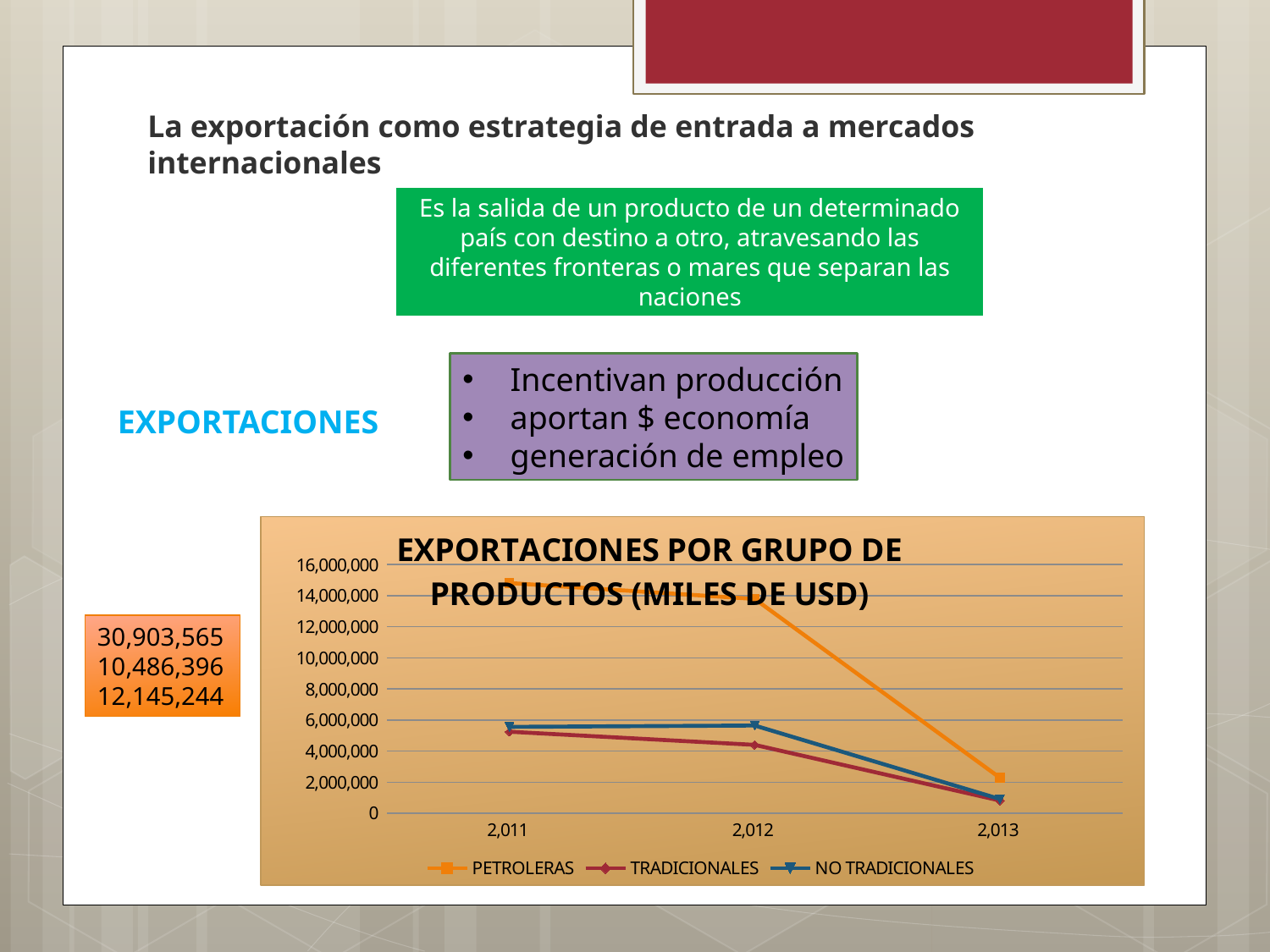
What is the title of the chart? EXPORTACIONES POR GRUPO DE PRODUCTOS (MILES DE USD) How many series does the chart legend list? 3 Is the value for TRADICIONALES in 2,011 greater or less than 6,000,000? less Is the value for PETROLERAS in 2,013 greater or less than 4,000,000? less In which year is the PETROLERAS value lowest? 2,013 Is the value for PETROLERAS in 2,011 greater or less than 14,000,000? greater Which series has the highest value in 2,011? PETROLERAS What kind of chart is shown on the slide? line chart What colour is the PETROLERAS line in the chart? orange In 2,012, which is larger: PETROLERAS or TRADICIONALES? PETROLERAS How many years are shown on the x axis of the chart? 3 Do the PETROLERAS values rise or fall from 2,011 to 2,013? fall